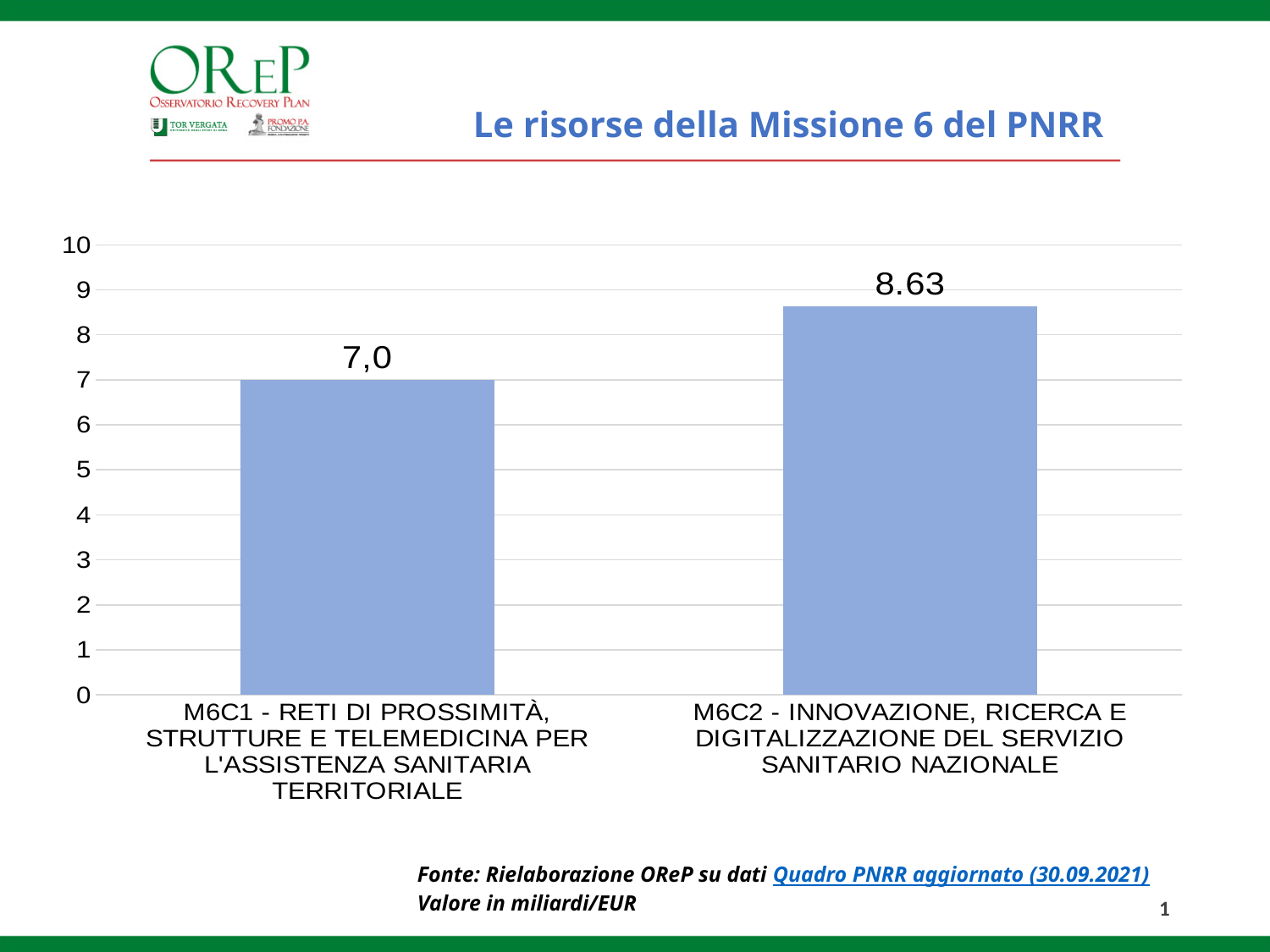
In what unit are the chart values expressed, according to the note on the slide? miliardi/EUR Which is larger, the value for M6C1 or the value for M6C2? M6C2 How many categories are shown in the chart? 2 What kind of chart is shown on the slide? bar chart Which category has the lowest value? M6C1 - Reti di prossimità, strutture e telemedicina per l'assistenza sanitaria territoriale Is the value for M6C1 greater or less than 8? less What is the value shown for M6C2 - Innovazione, ricerca e digitalizzazione del Servizio Sanitario Nazionale? 8.63 What is the title of the slide containing the chart? Le risorse della Missione 6 del PNRR Is the value for M6C2 greater or less than 8? greater What is the value shown for M6C1 - Reti di prossimità, strutture e telemedicina per l'assistenza sanitaria territoriale? 7,0 Which category has the highest value? M6C2 - Innovazione, ricerca e digitalizzazione del Servizio Sanitario Nazionale What is the difference between the values for M6C2 and M6C1? 1.63